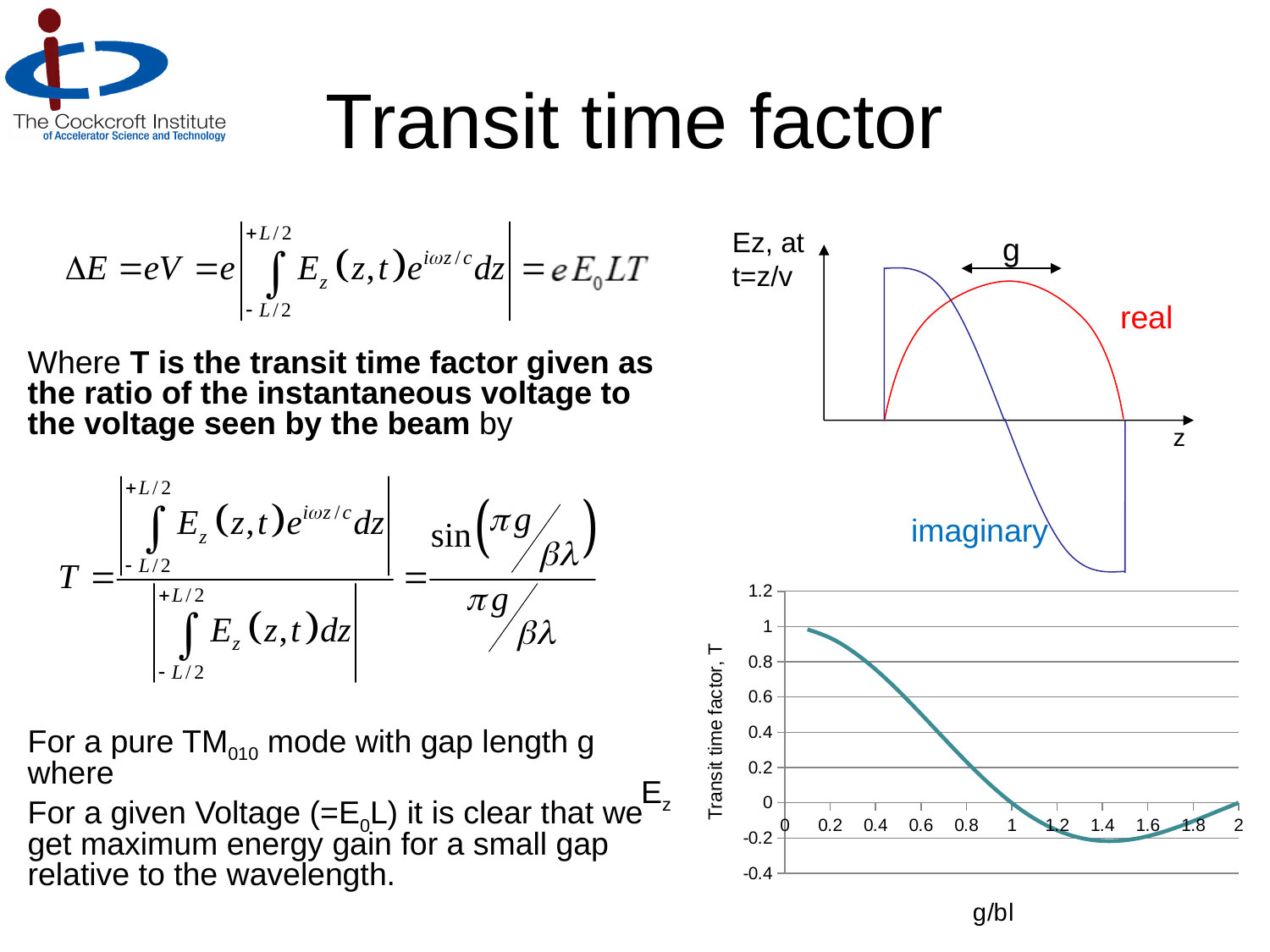
In the Transit time factor chart, at what value of g/bl does T first cross zero? 1 In the Transit time factor chart, is the value of T at g/bl = 1.4 greater or less than 0? less What is the label on the x axis of the Transit time factor chart? g/bl In the Transit time factor chart, which is larger: T at g/bl = 0.2 or T at g/bl = 1.2? T at g/bl = 0.2 In the Transit time factor chart, is the value of T at g/bl = 0.2 greater or less than 0.8? greater How many lines are plotted in the Transit time factor chart? 1 What kind of chart is the plot of Transit time factor, T against g/bl? line chart What is the label on the y axis of the chart at the bottom right? Transit time factor, T In the Transit time factor chart, does T rise or fall as g/bl increases from 0 to 1? fall In the Transit time factor chart, is the value of T at g/bl = 0.6 greater or less than 0.6? less